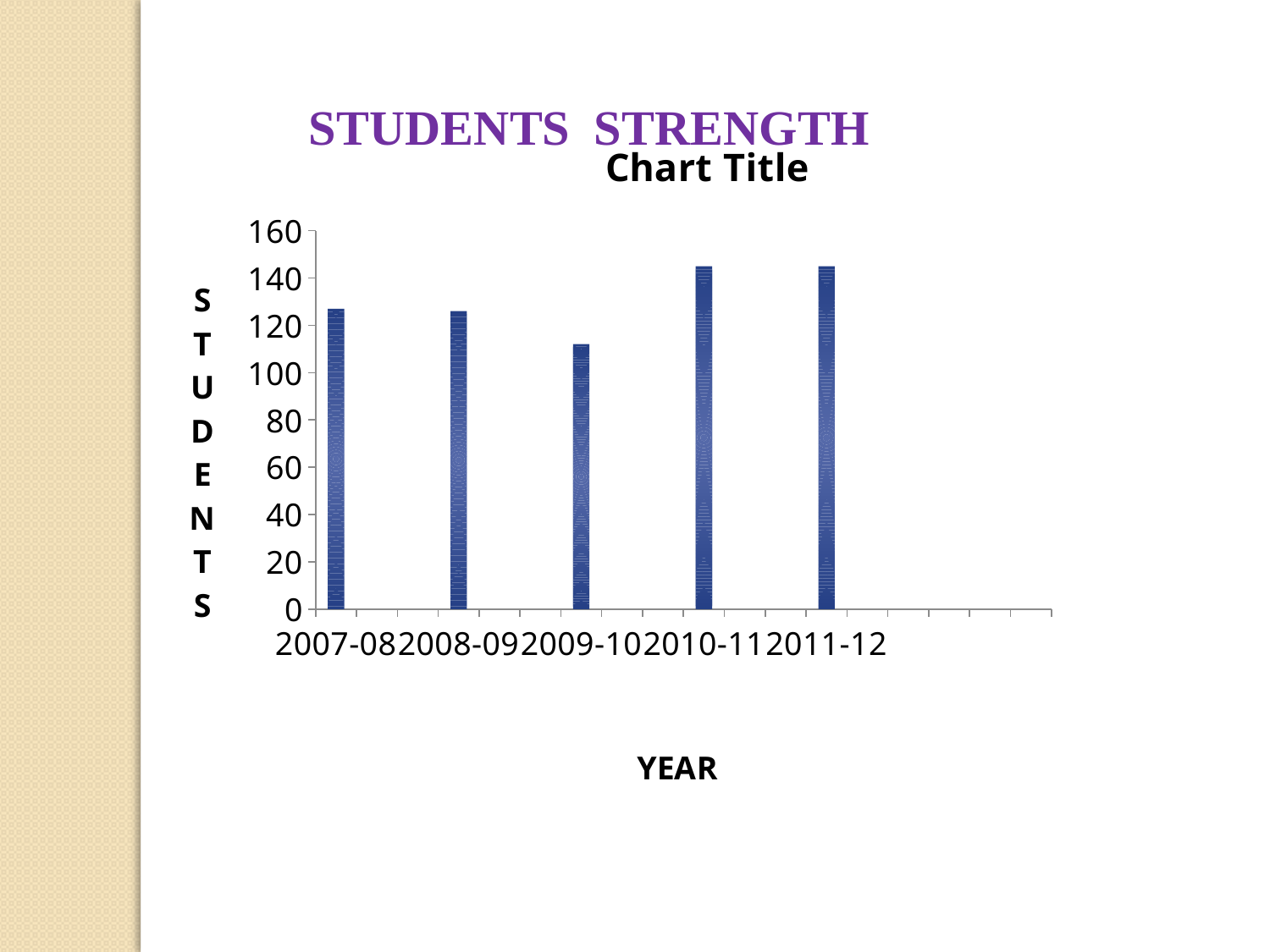
How many years are shown on the x axis of the chart? 5 What is the title of the x axis of the chart? YEAR What kind of chart is shown on the slide? bar chart What is the title of the y axis of the chart? STUDENTS Is the value for 2009-10 greater or less than 100? greater Is the value for 2007-08 greater or less than 140? less Is the value for 2011-12 greater or less than 140? greater Which year has the lowest student strength? 2009-10 Which is larger, the value for 2010-11 or the value for 2009-10? 2010-11